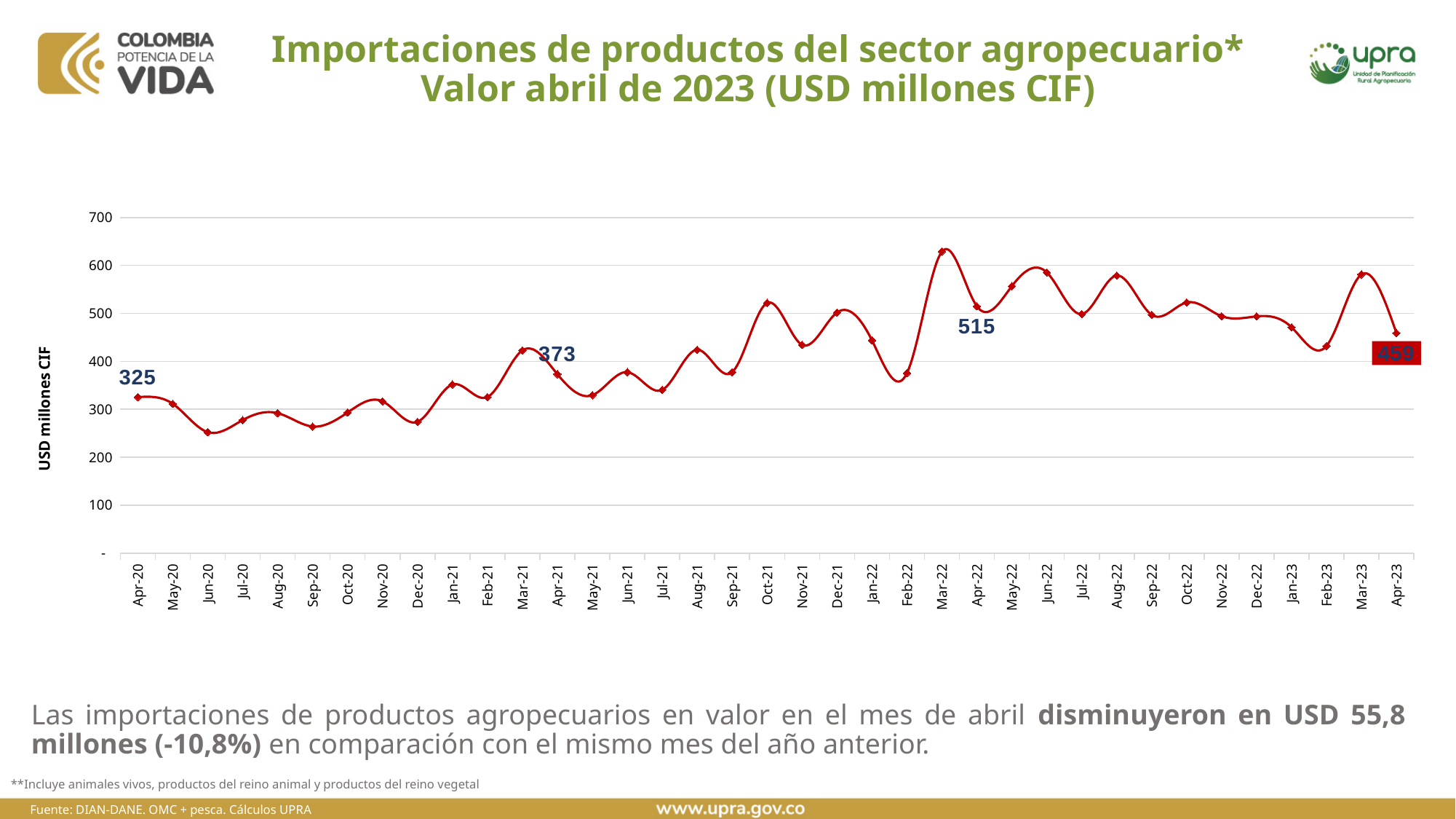
What is the value for Apr-23? 459 What is the value for Apr-20? 325 What is the difference between the values for Apr-22 and Apr-21? 142 What is the label of the vertical axis? USD millones CIF What is the value for Apr-21? 373 Which month has the lowest value on the chart? Jun-20 Which is larger, the value for Apr-22 or the value for Apr-23? Apr-22 What kind of chart is shown on the slide? line chart Is the value for Mar-22 greater or less than 600? greater Is the value for Jun-20 greater or less than 300? less Which month has the highest value on the chart? Mar-22 What is the value for Apr-22? 515